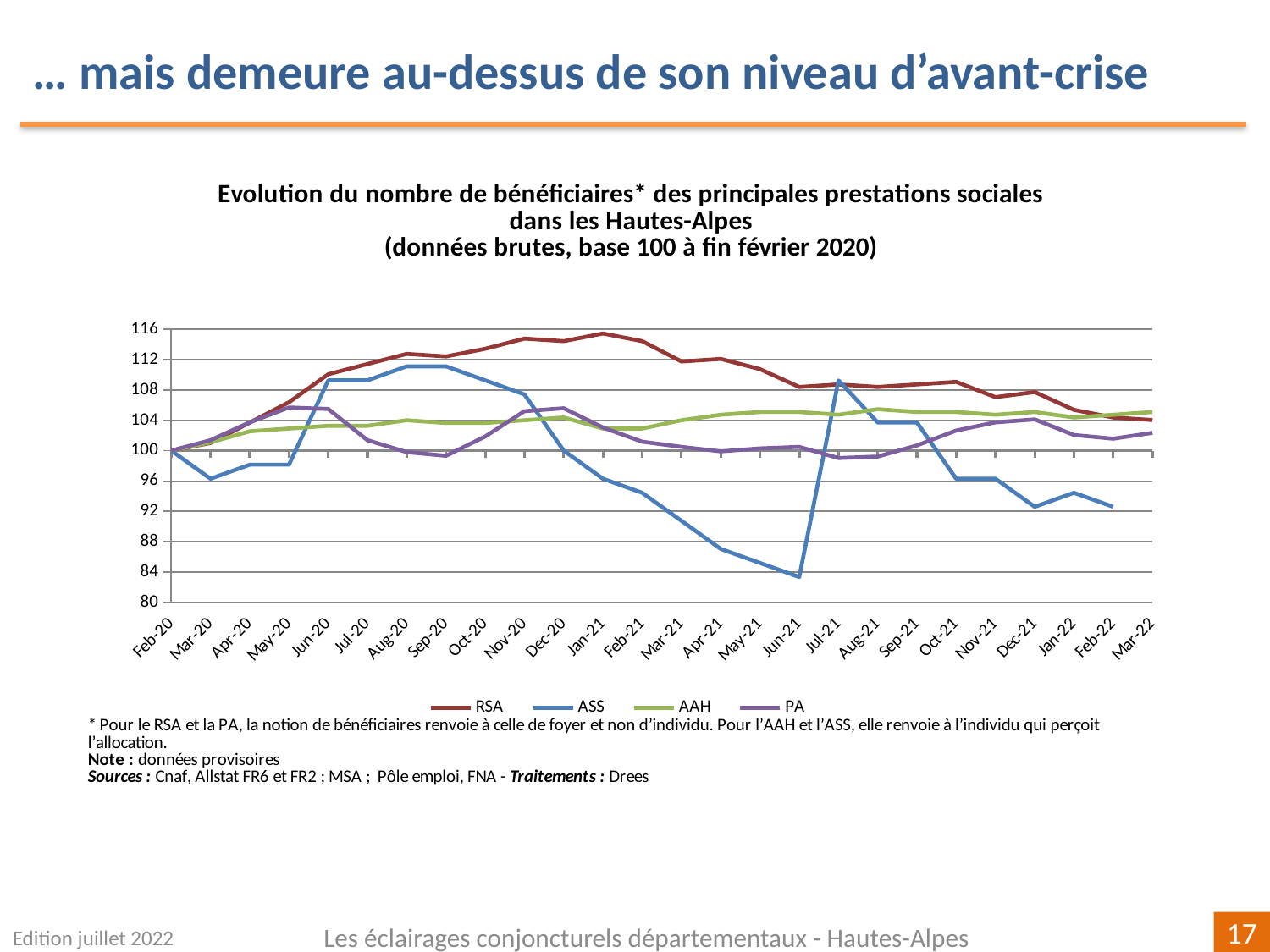
Is the value for RSA in Jan-21 greater or less than 112? greater How many monthly points are plotted along the x axis, from Feb-20 to Mar-22? 26 What colour is the line for the ASS series? blue Is the value for ASS in Jun-21 greater or less than 88? less Does the ASS series rise or fall between Jan-21 and Jun-21? fall In Mar-21, which is larger, the value for RSA or the value for ASS? RSA How many series does the legend list? 4 Which series has the highest value in Jan-21? RSA What kind of chart is shown on the slide? line chart Which series are listed in the legend? RSA, ASS, AAH, PA Which series has the lowest value in Jun-21? ASS